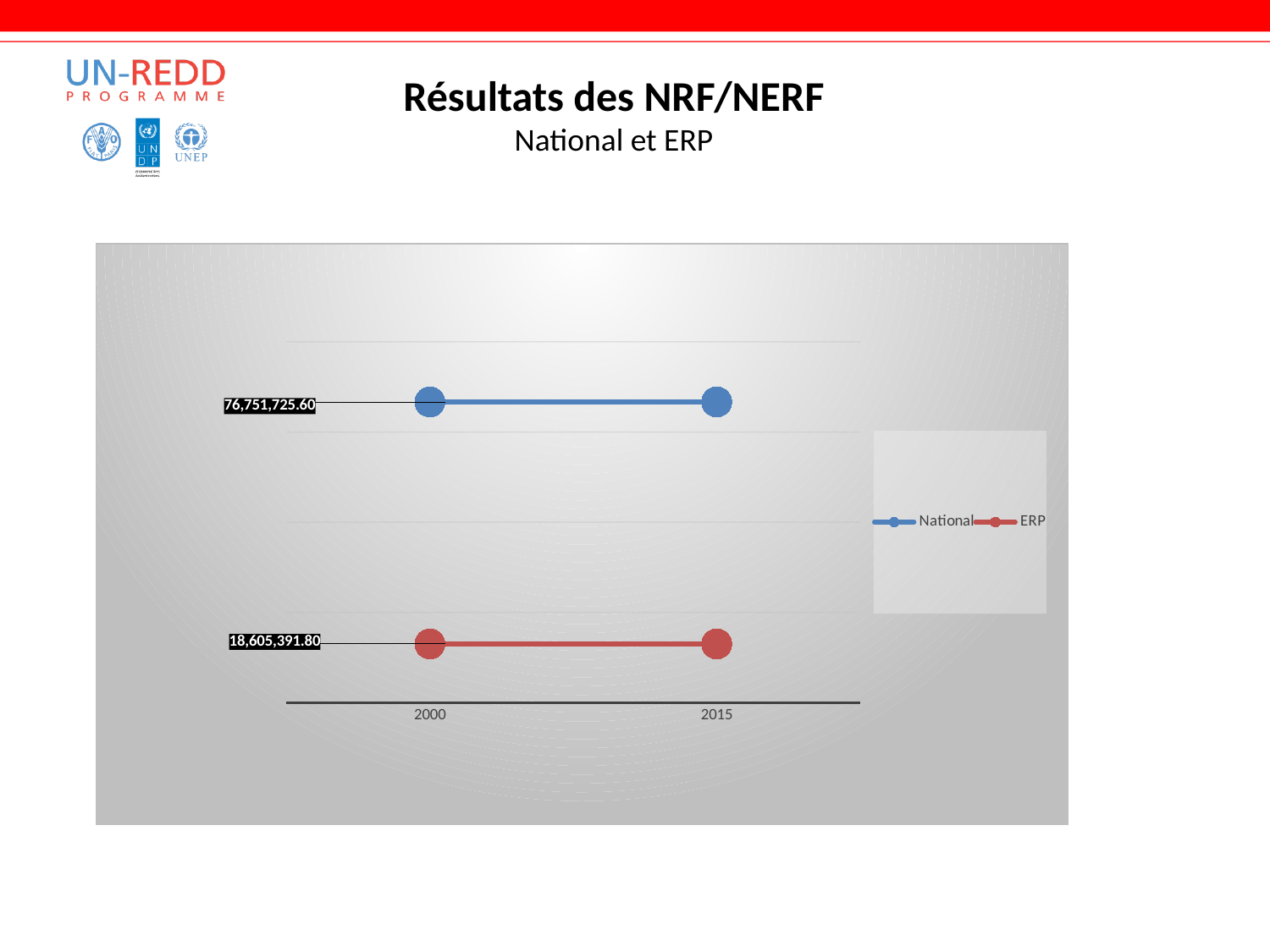
Does the ERP line rise, fall or stay flat from 2000 to 2015? Stays flat Which series has the lowest value? ERP What kind of chart is shown on the slide? Line chart What value is labelled for the ERP series? 18,605,391.80 Which series are listed in the legend? National and ERP What are the two x-axis labels? 2000 and 2015 What value is labelled for the National series? 76,751,725.60 What is the difference between the National value and the ERP value? 58,146,333.80 Does the National line rise, fall or stay flat from 2000 to 2015? Stays flat How many series does the legend list? 2 Which series has the higher value, National or ERP? National How many points are shown on the x axis? 2